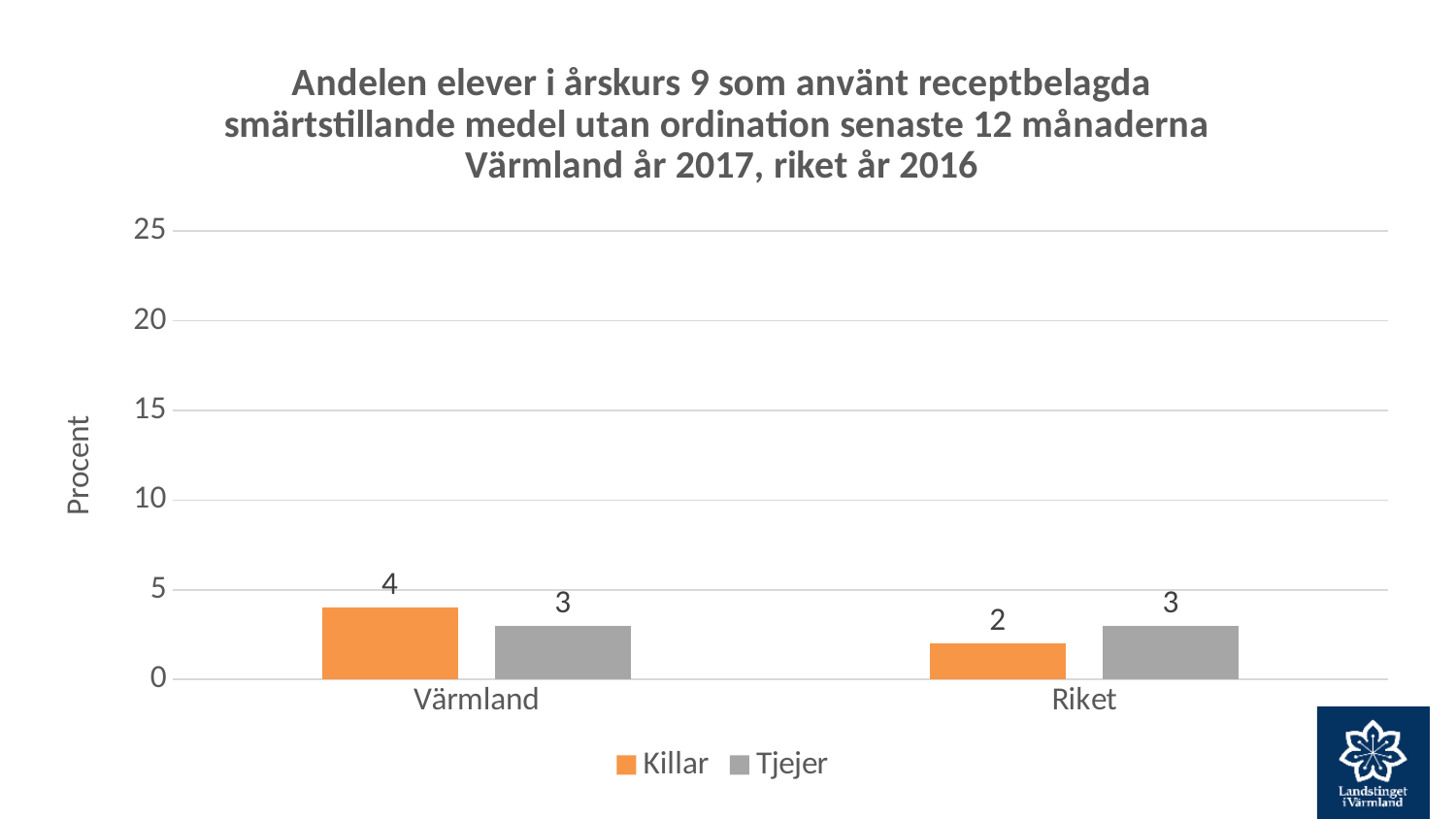
In Riket, which is larger, Killar or Tjejer? Tjejer What is the value for Tjejer in Värmland? 3 How many categories are shown on the x axis? 2 What is the value for Killar in Värmland? 4 What is the difference between the Killar values for Värmland and Riket? 2 How many series does the legend list? 2 Which category has the lowest value for Killar? Riket What is the value for Tjejer in Riket? 3 In Värmland, which is larger, Killar or Tjejer? Killar Which category has the highest value for Killar? Värmland What kind of chart is shown on the slide? Bar chart What is the value for Killar in Riket? 2